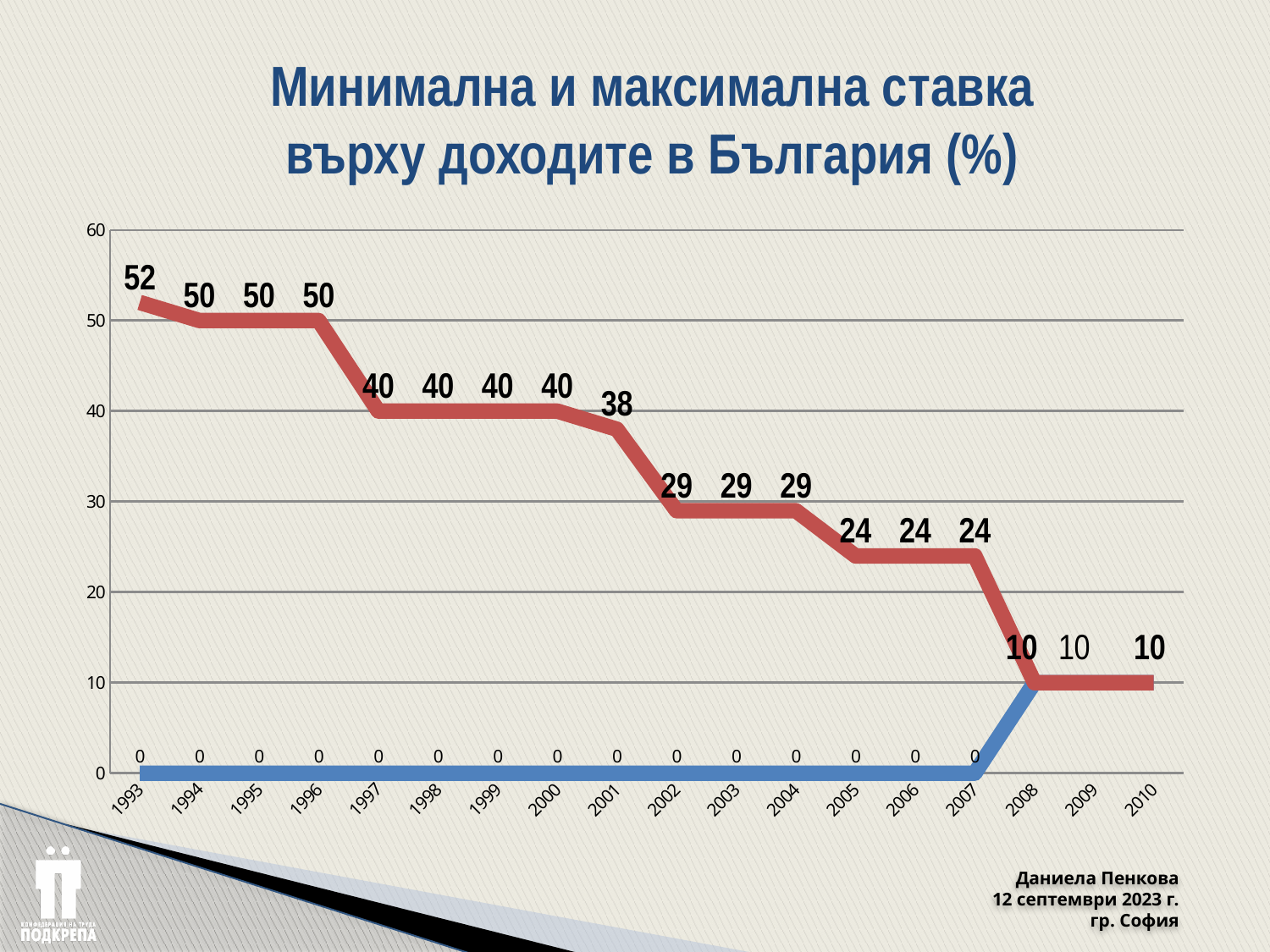
Which is larger: the red line's value in 2002 or its value in 2004? They are equal (29) What is the difference between the red line's value in 2007 and its value in 2008? 14 In which year does the red (upper) line reach its highest value? 1993 What is the difference between the red line's value in 1996 and its value in 1997? 10 How many years are shown on the x axis? 18 What is the value of the red (upper) line for 1993? 52 Does the red (upper) line rise or fall from 1993 to 2010? fall What is the value of the red (upper) line for 2001? 38 What is the value of the blue (lower) line for 2000? 0 What is the value of the red (upper) line for 2005? 24 What kind of chart is shown on the slide? line chart What is the title of the chart? Минимална и максимална ставка върху доходите в България (%)